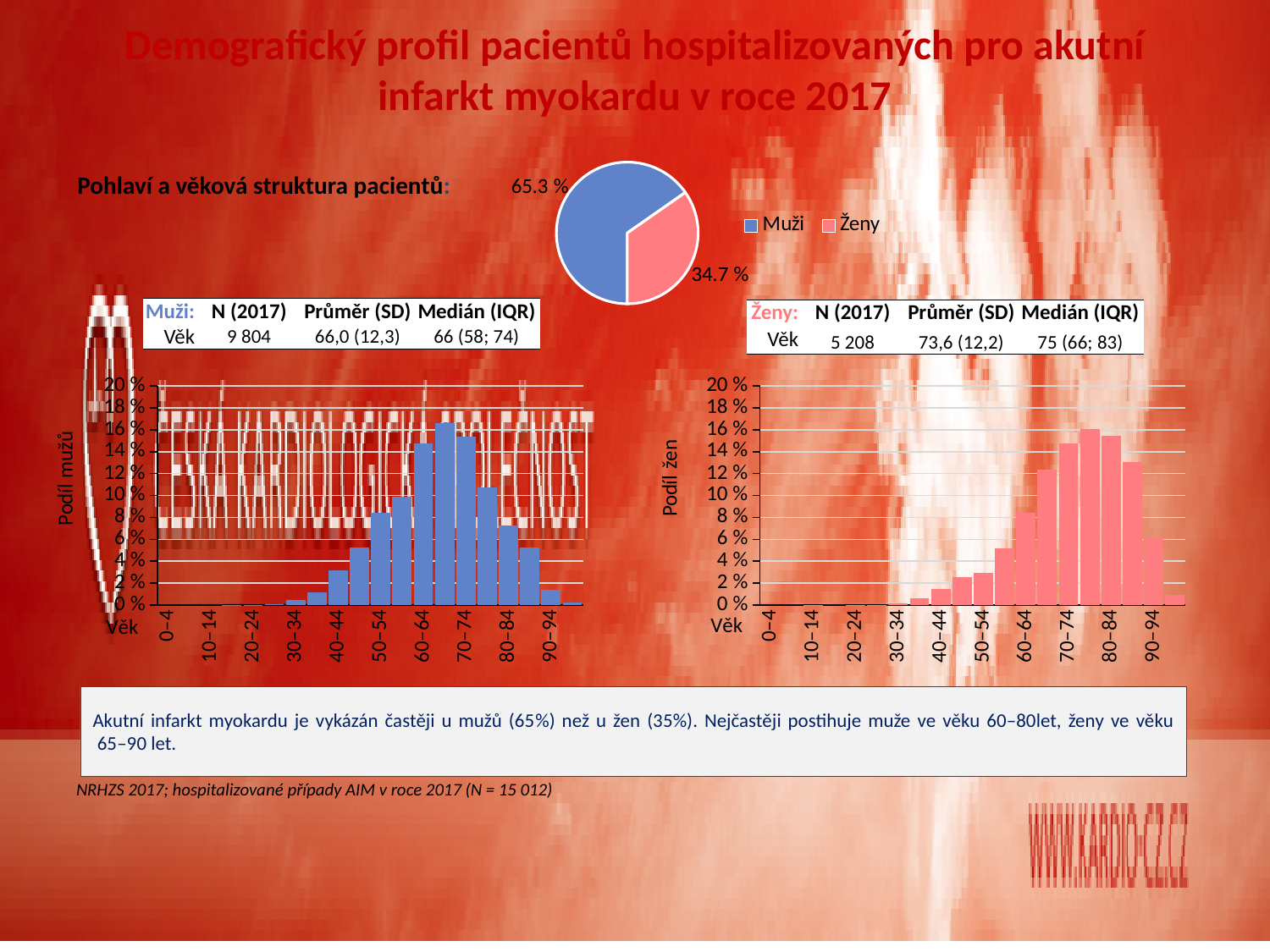
In the pie chart, what share of patients are Ženy? 34.7 % In the 'Podíl žen' chart on the right, which age group has the larger value, 70–74 or 90–94? 70–74 In the 'Podíl žen' chart on the right, is the value for the 70–74 age group greater or less than 12 %? greater In the 'Podíl mužů' chart on the left, do the values rise or fall from the 70–74 age group to the 90–94 age group? fall How many entries does the legend of the pie chart list? 2 In the pie chart, what is the difference in percentage points between the Muži and Ženy shares? 30.6 % What kind of chart shows the Muži and Ženy shares? Pie chart In the 'Podíl mužů' chart on the left, is the value for the 80–84 age group greater or less than 8 %? less In the 'Podíl mužů' chart on the left, is the value for the 60–64 age group greater or less than 12 %? greater What kind of chart is the 'Podíl mužů' chart on the left? Bar chart In the pie chart, what share of patients are Muži? 65.3 % In the pie chart, which group has the larger share, Muži or Ženy? Muži